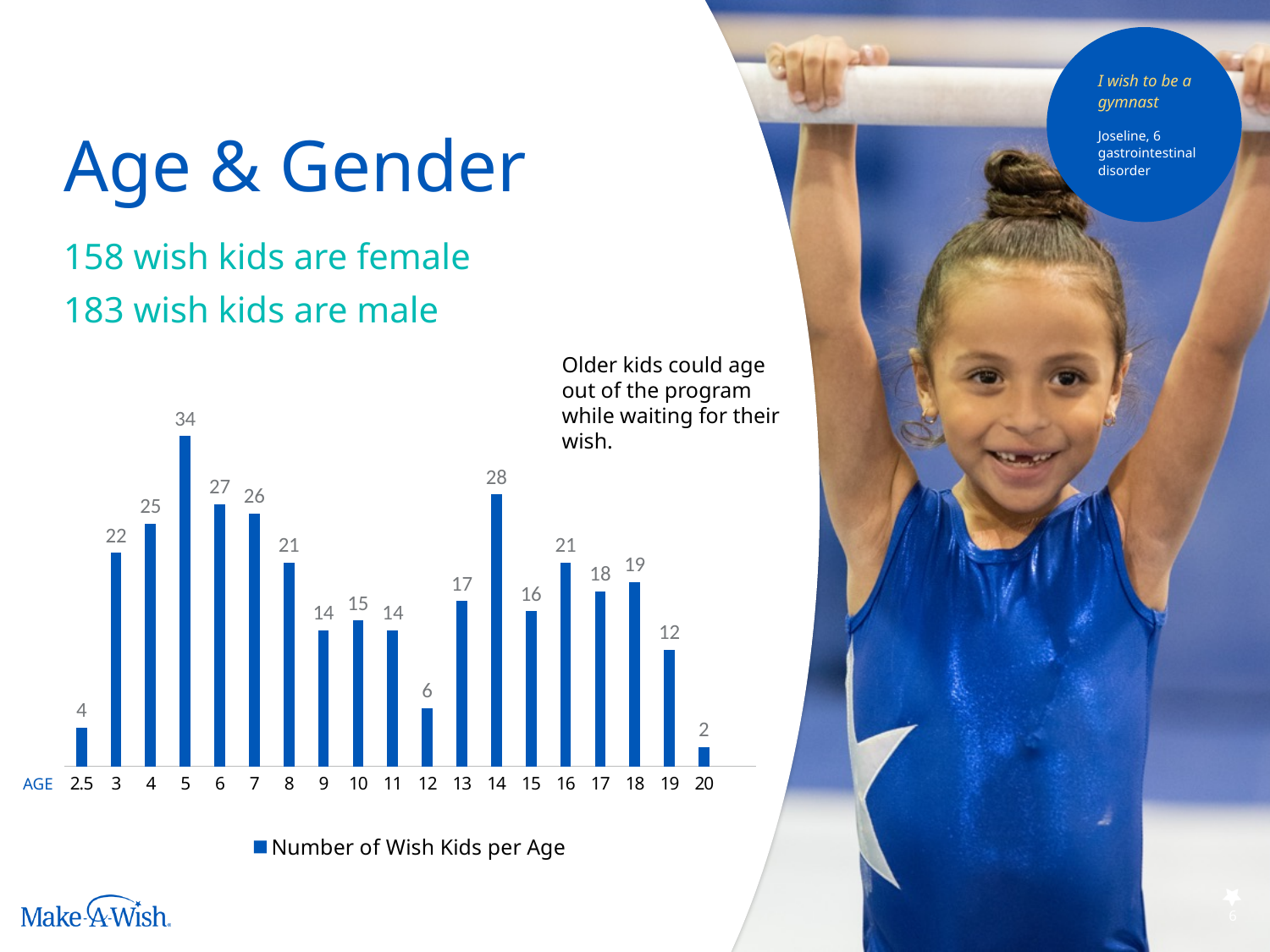
Which has more wish kids, age 3 or age 19? Age 3 What is the difference between the number of wish kids at age 5 and at age 6? 7 What is the number of wish kids at age 14? 28 What is the difference between the number of wish kids at age 14 and at age 12? 22 How many age categories are shown on the x axis of the chart? 19 Which has more wish kids, age 13 or age 16? Age 16 What is the number of wish kids at age 2.5? 4 Which age has the highest number of wish kids? 5 Which age has the lowest number of wish kids? 20 What kind of chart is used to show the number of wish kids per age? Bar chart What is the legend entry for the series in the chart? Number of Wish Kids per Age What is the number of wish kids at age 5? 34